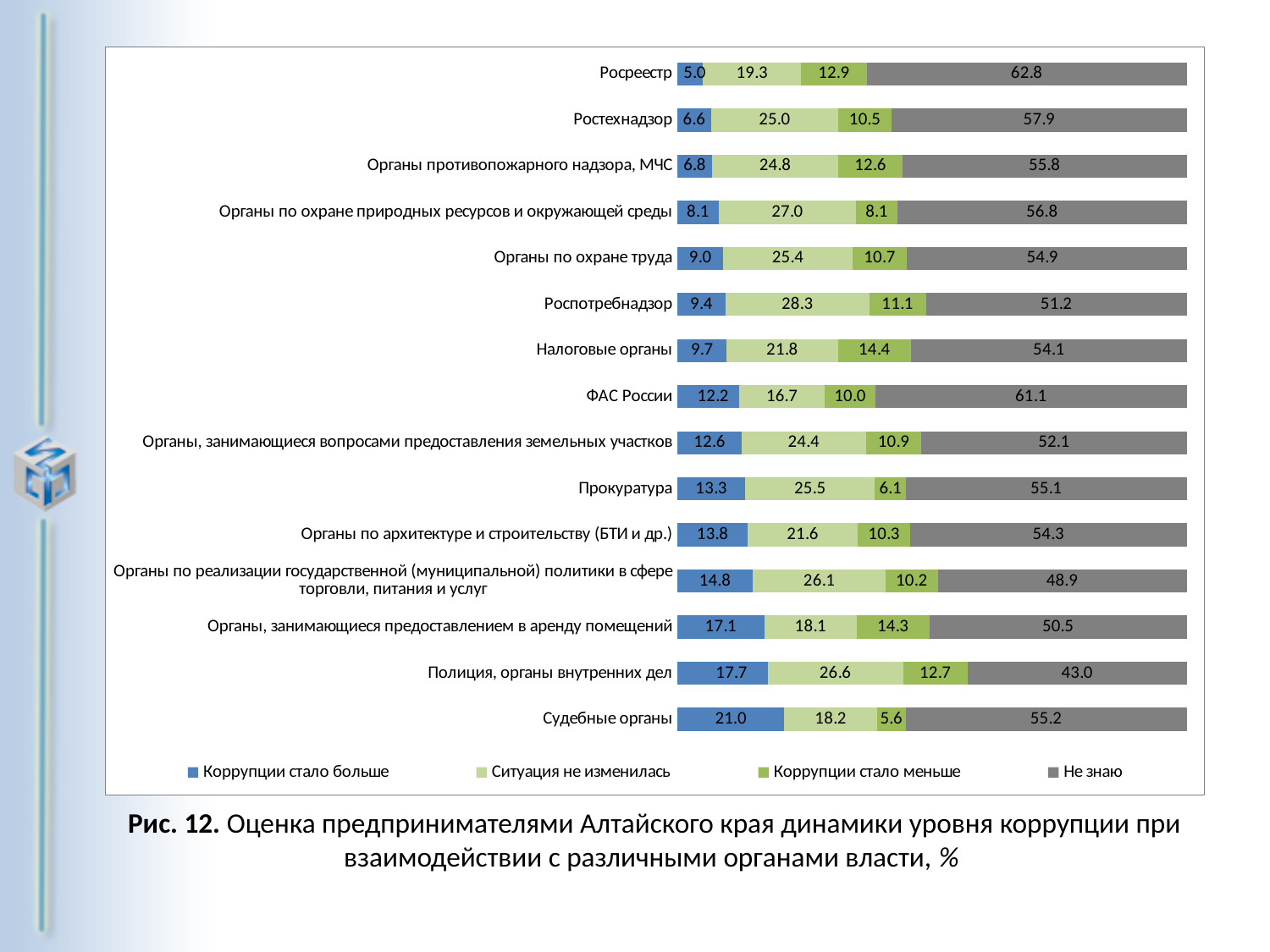
Which is larger: the "Не знаю" value for ФАС России or for Прокуратура? ФАС России What is the value of "Не знаю" for Росреестр? 62.8 What type of chart is shown on the slide? Stacked bar chart What is the total of the stacked bar for Росреестр? 100.0 Which body has the lowest value for "Коррупции стало меньше"? Судебные органы What is the value of "Коррупции стало больше" for Полиция, органы внутренних дел? 17.7 What is the difference between the "Коррупции стало больше" values for Судебные органы and Росреестр? 16.0 What is the value of "Ситуация не изменилась" for Роспотребнадзор? 28.3 Which body has the highest value for "Коррупции стало больше"? Судебные органы Which body has the lowest value for "Не знаю"? Полиция, органы внутренних дел How many government bodies (categories) are shown in the chart? 15 How many series does the legend list? 4